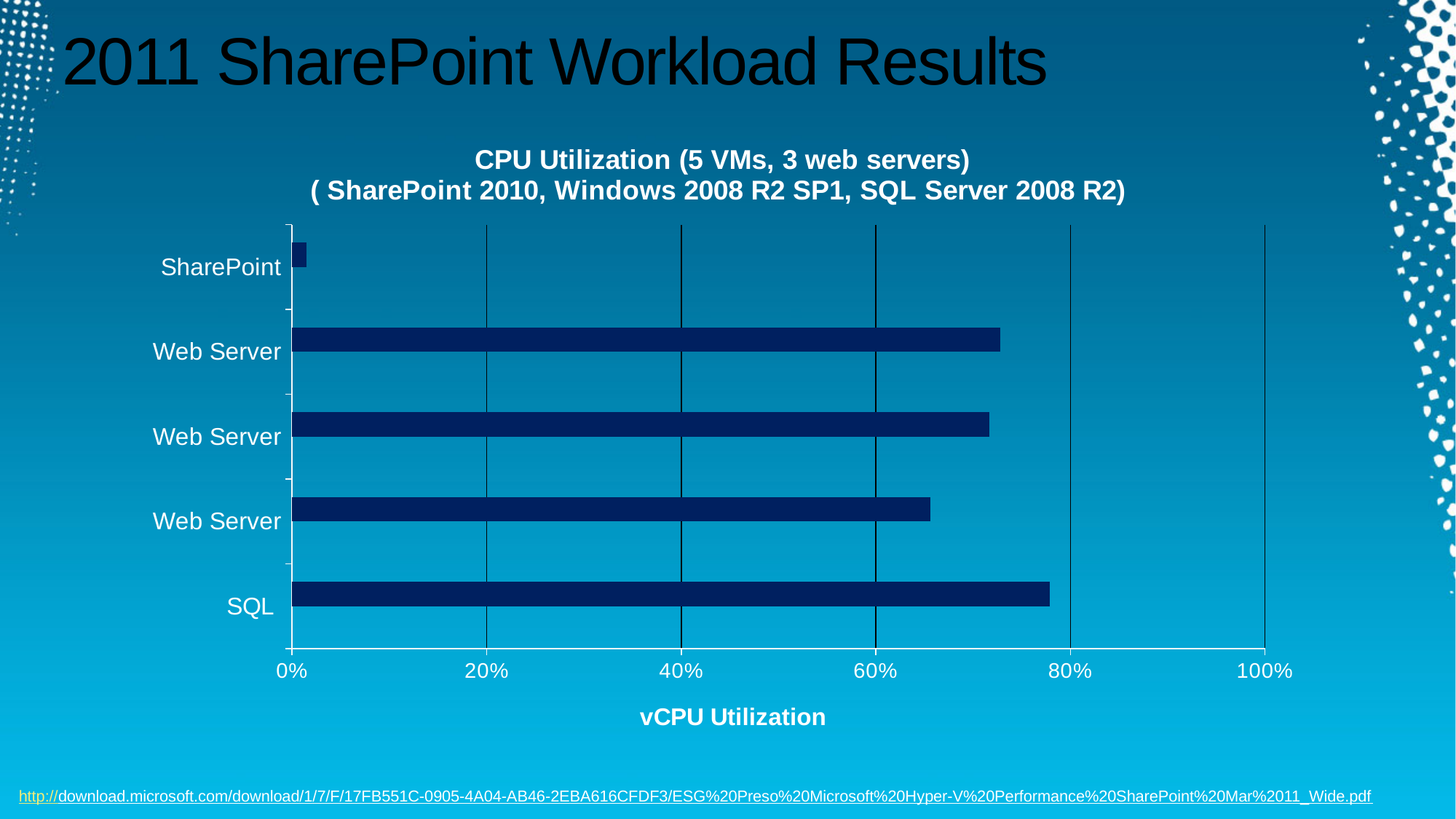
How many bars (categories) are plotted in the CPU Utilization chart? 5 Which has the larger vCPU utilization, SQL or the bottom Web Server bar (just above SQL)? SQL Is the vCPU utilization for SharePoint greater or less than 20%? less Is the vCPU utilization for the bottom Web Server bar (just above SQL) greater or less than 60%? greater What is the title of the x axis of the chart? vCPU Utilization Which category has the highest vCPU utilization? SQL Is the vCPU utilization for SQL greater or less than 80%? less Which category has the lowest vCPU utilization? SharePoint What kind of chart is shown on the slide? Bar chart What is the first line of the chart's title? CPU Utilization (5 VMs, 3 web servers)